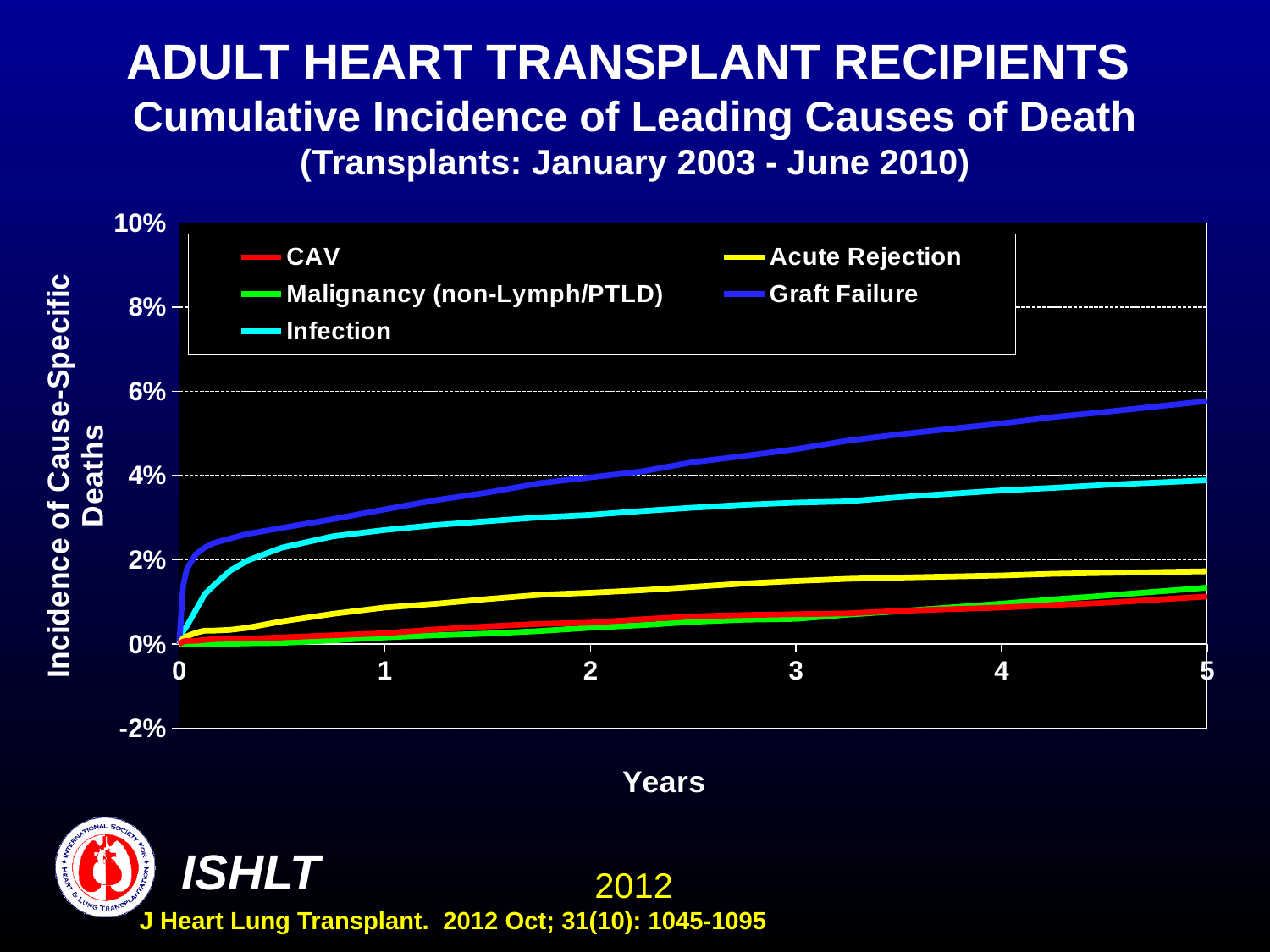
Which cause of death has the highest cumulative incidence at 5 years? Graft Failure At 5 years, which is larger: the value for Infection or the value for Acute Rejection? Infection What is the label of the x axis? Years Is the value for Infection at 5 years greater or less than 2%? greater How many labelled tick marks are on the x axis? 6 How many series does the legend list? 5 Is the value for Infection at 1 year greater or less than 4%? less What kind of chart is shown on the slide? line chart Does the Graft Failure line rise or fall as years increase? rise Is the value for Acute Rejection at 5 years greater or less than 2%? less